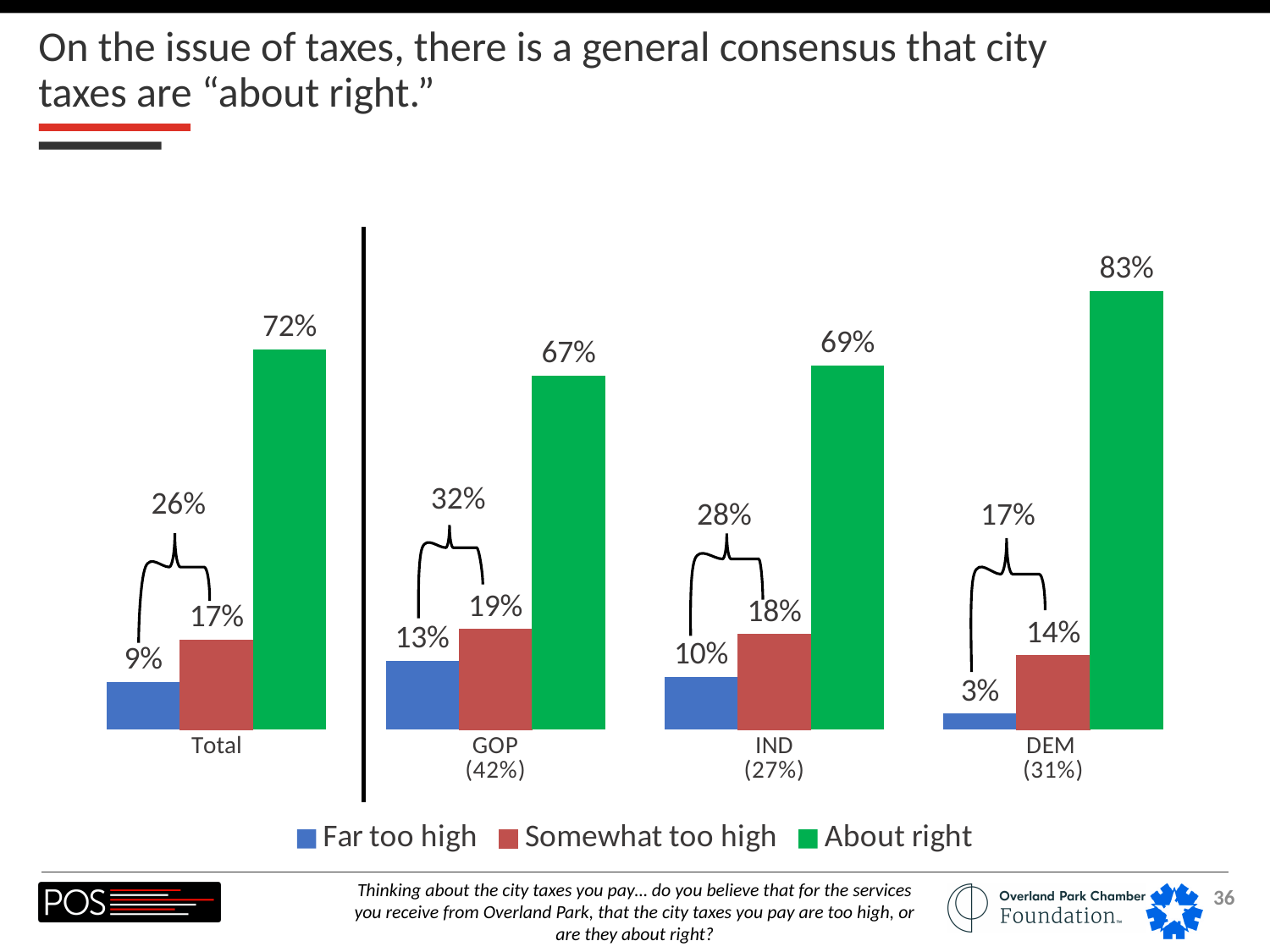
What is the difference between the "About right" values for DEM and GOP? 16% How many groups are shown on the x axis? 4 Which colour represents "About right" in the legend? Green What kind of chart is shown on the slide? Bar chart What is the "Far too high" value for DEM? 3% What is the combined "Far too high" and "Somewhat too high" value shown for IND? 28% What percentage of the Total group says city taxes are "About right"? 72% What is the "Somewhat too high" value for GOP? 19% Which group has the highest "About right" value? DEM Which is larger, the "Somewhat too high" value for IND or for DEM? IND Which group has the lowest "Far too high" value? DEM How many series does the legend list? 3